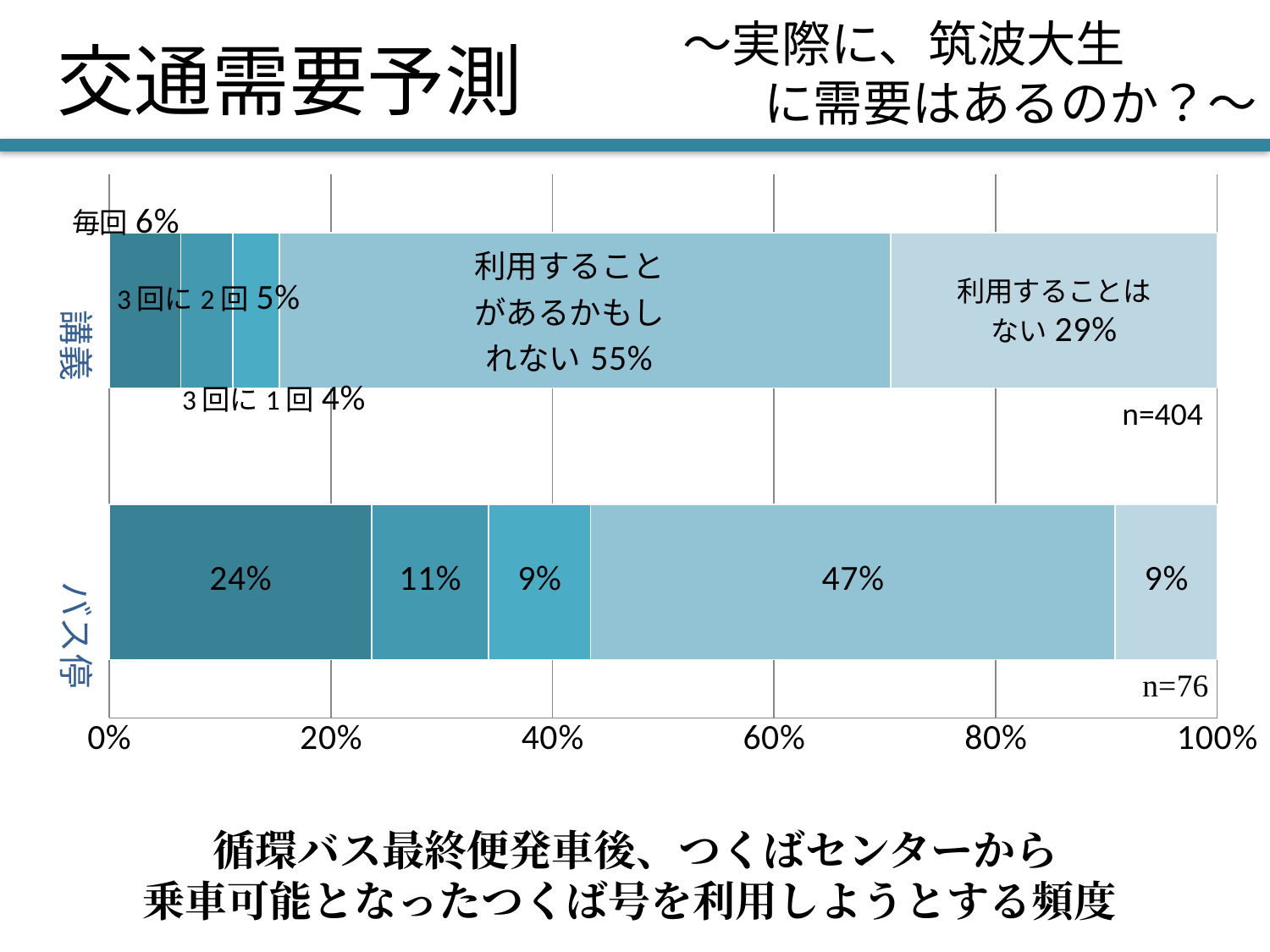
What is the value of the first (darkest) segment of the バス停 bar? 24% What is the value of 利用することがあるかもしれない for 講義? 55% What is the sample size (n) shown for バス停? n=76 What is the difference between 利用することがあるかもしれない (55%) and 利用することはない (29%) for 講義? 26% Which segment of the 講義 bar is the smallest? 3回に1回 What is the value of 毎回 for 講義? 6% What is the value of 利用することはない for 講義? 29% How many categories (bars) does the chart show? 2 What is the value of the largest segment of the バス停 bar? 47% What is the sample size (n) shown for 講義? n=404 Which is larger: the 毎回 value for 講義 (6%) or the first segment of the バス停 bar (24%)? バス停 (24%) What kind of chart is shown on the slide? stacked bar chart